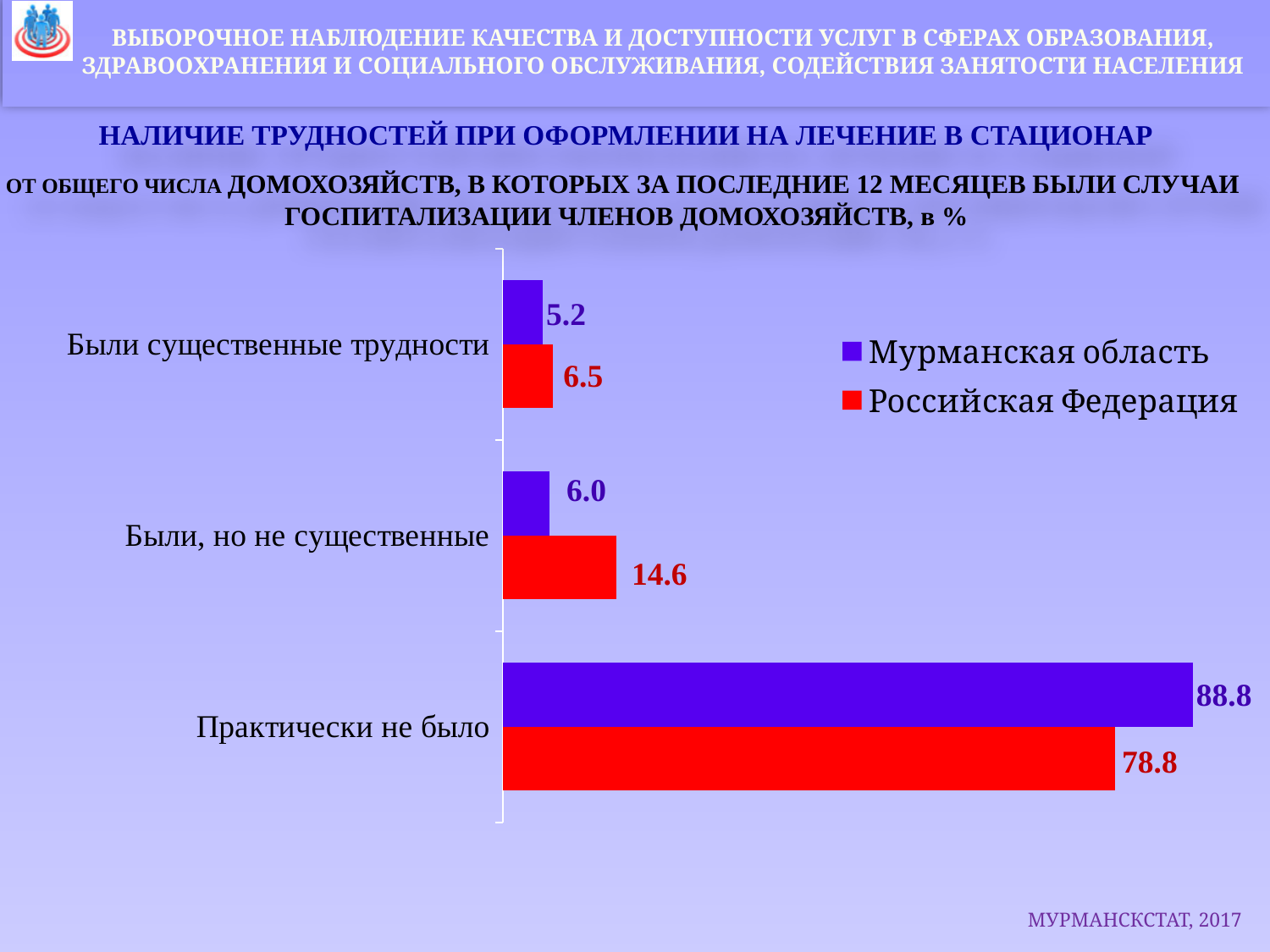
In the category 'Были, но не существенные', which series has the larger value: Мурманская область or Российская Федерация? Российская Федерация What value is shown for Российская Федерация in the category 'Были, но не существенные'? 14.6 What kind of chart is shown on the slide? Bar chart What is the difference between Российская Федерация and Мурманская область in the category 'Были, но не существенные'? 8.6 How many series does the legend list? 2 What value is shown for Мурманская область in the category 'Были существенные трудности'? 5.2 What is the difference between Мурманская область and Российская Федерация in the category 'Практически не было'? 10.0 Which category has the highest value for Российская Федерация? Практически не было What value is shown for Мурманская область in the category 'Практически не было'? 88.8 Which category has the lowest value for Мурманская область? Были существенные трудности How many categories are shown on the chart? 3 What value is shown for Российская Федерация in the category 'Были существенные трудности'? 6.5